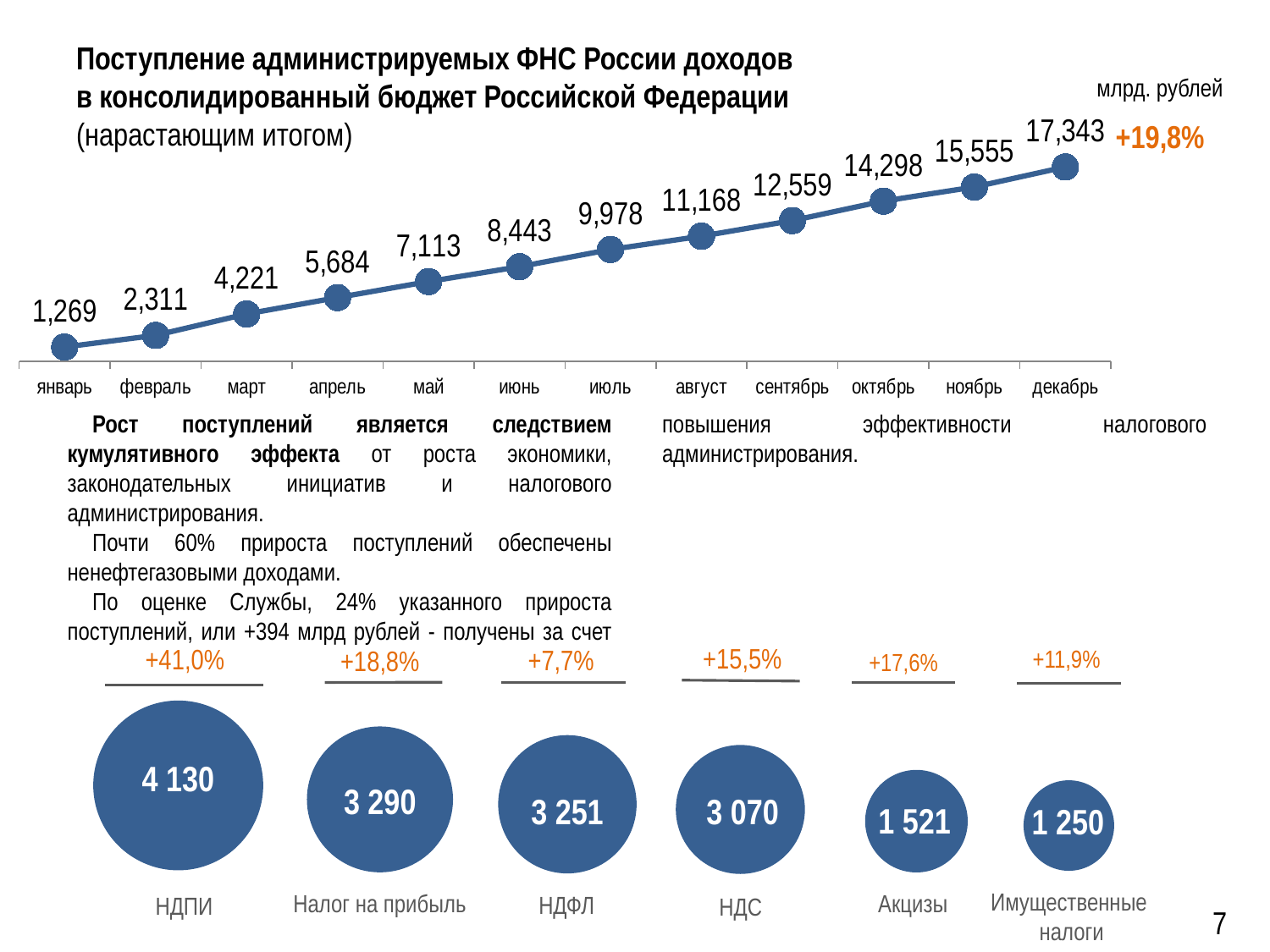
On the line chart at the top, what is the cumulative value for май (May)? 7,113 What type of chart is shown at the top of the slide? line chart On the bubble chart at the bottom, what is the value for НДС? 3 070 On the bubble chart at the bottom, what growth percentage is shown above Акцизы? +17,6% On the bubble chart at the bottom, which tax category has the lowest value? Имущественные налоги On the line chart at the top, what growth percentage is shown in orange next to the December value? +19,8% On the line chart at the top, what is the difference between the values for сентябрь and август? 1,391 On the line chart at the top, what is the cumulative value for декабрь (December)? 17,343 On the bubble chart at the bottom, which tax category has the highest value? НДПИ On the bubble chart at the bottom, what is the difference between the values for Налог на прибыль and НДФЛ? 39 On the line chart at the top, how many monthly data points are plotted? 12 On the line chart at the top, do the values rise or fall from январь to декабрь? rise